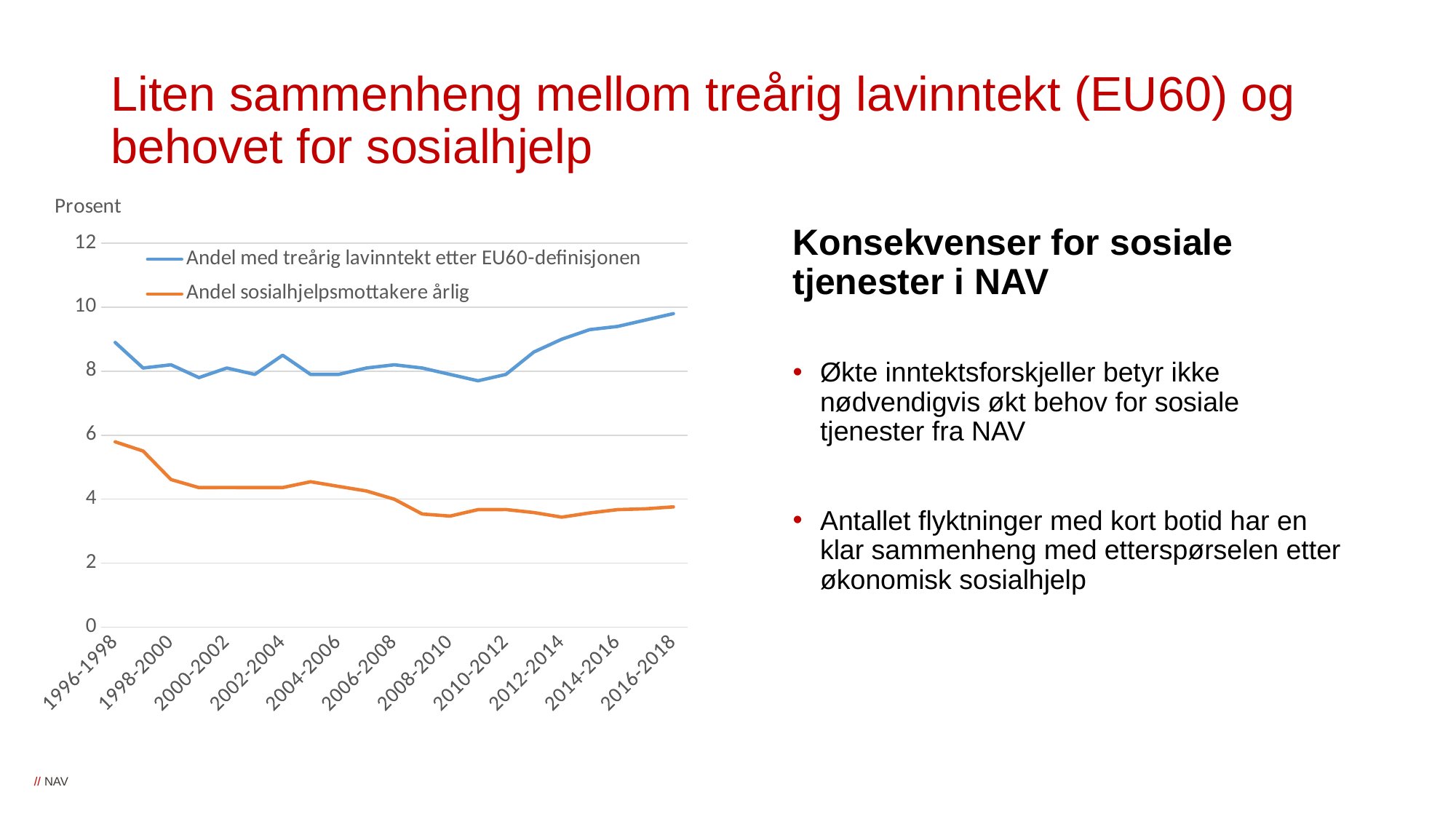
In which period does 'Andel med treårig lavinntekt etter EU60-definisjonen' reach its highest value? 2016-2018 How many series does the chart legend list? 2 Is the value for 'Andel sosialhjelpsmottakere årlig' in 2008-2010 greater or less than 4? less Is the value for 'Andel sosialhjelpsmottakere årlig' in 1996-1998 greater or less than 4? greater What kind of chart is shown on the slide? Line chart Is the value for 'Andel med treårig lavinntekt etter EU60-definisjonen' in 2016-2018 greater or less than 8? greater Which colour is used for the series 'Andel sosialhjelpsmottakere årlig'? Orange What is the label on the y axis of the chart? Prosent In which period does 'Andel sosialhjelpsmottakere årlig' reach its highest value? 1996-1998 Does the series 'Andel sosialhjelpsmottakere årlig' rise or fall from 1996-1998 to 2016-2018? Fall Which series has the higher value in 2016-2018, 'Andel med treårig lavinntekt etter EU60-definisjonen' or 'Andel sosialhjelpsmottakere årlig'? Andel med treårig lavinntekt etter EU60-definisjonen